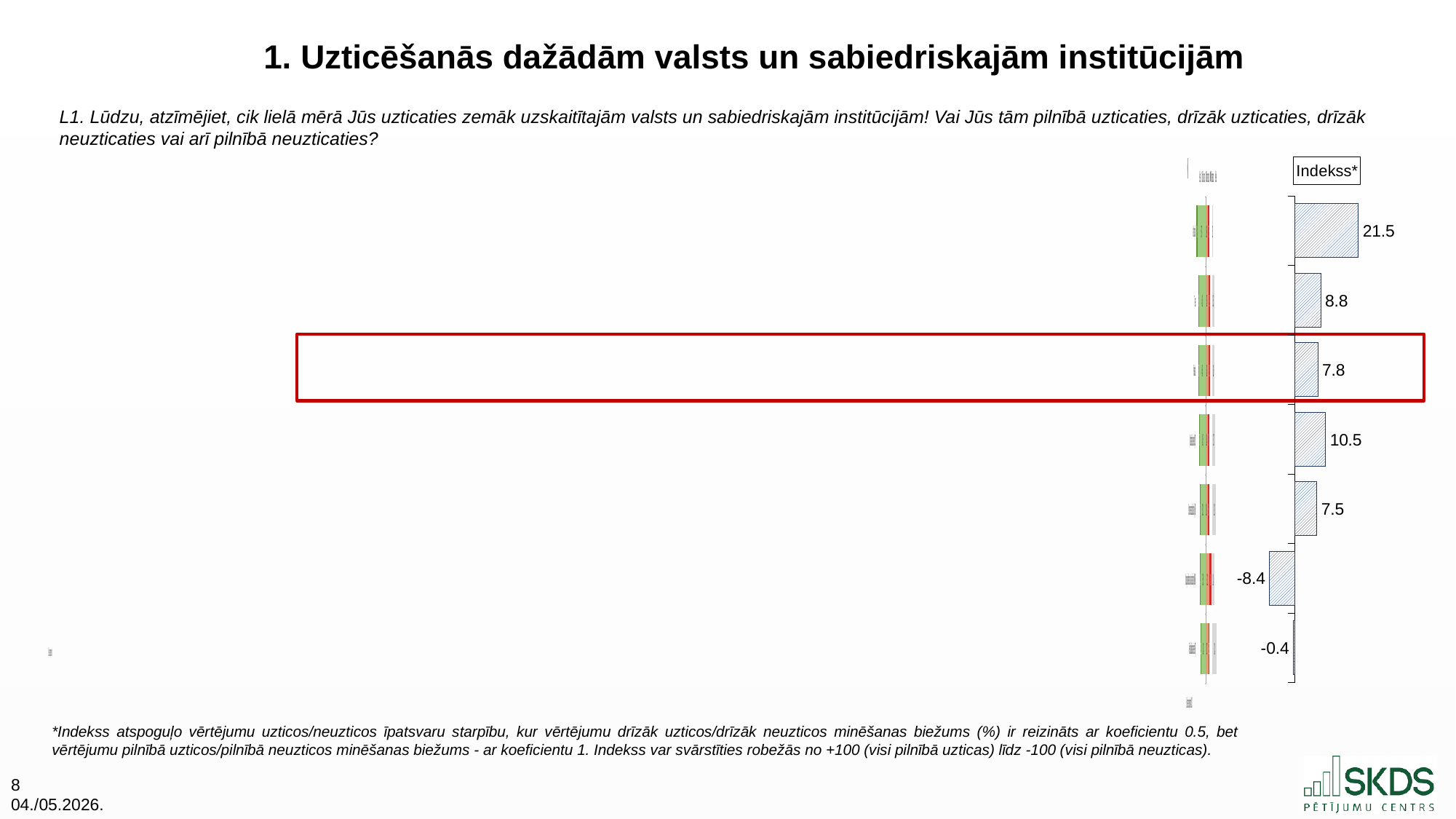
How many bars are plotted in the Indekss* chart? 7 In the Indekss* chart, what is the difference between the fourth bar (10.5) and the fifth bar (7.5)? 3.0 In the Indekss* chart, what is the value of the fourth bar from the top? 10.5 In the Indekss* chart, what is the highest value shown? 21.5 How many bars in the Indekss* chart have a negative value? 2 In the Indekss* chart, what is the value of the bottommost bar? -0.4 In the Indekss* chart, what is the value of the topmost bar? 21.5 In the Indekss* chart, which is larger: the second bar from the top or the third bar from the top? the second bar (8.8) In the Indekss* chart, what is the value of the bar in the row highlighted by the red box? 7.8 What kind of chart is the Indekss* chart? bar chart In the Indekss* chart, what is the lowest value shown? -8.4 In the Indekss* chart, what is the difference between the topmost bar (21.5) and the second bar (8.8)? 12.7